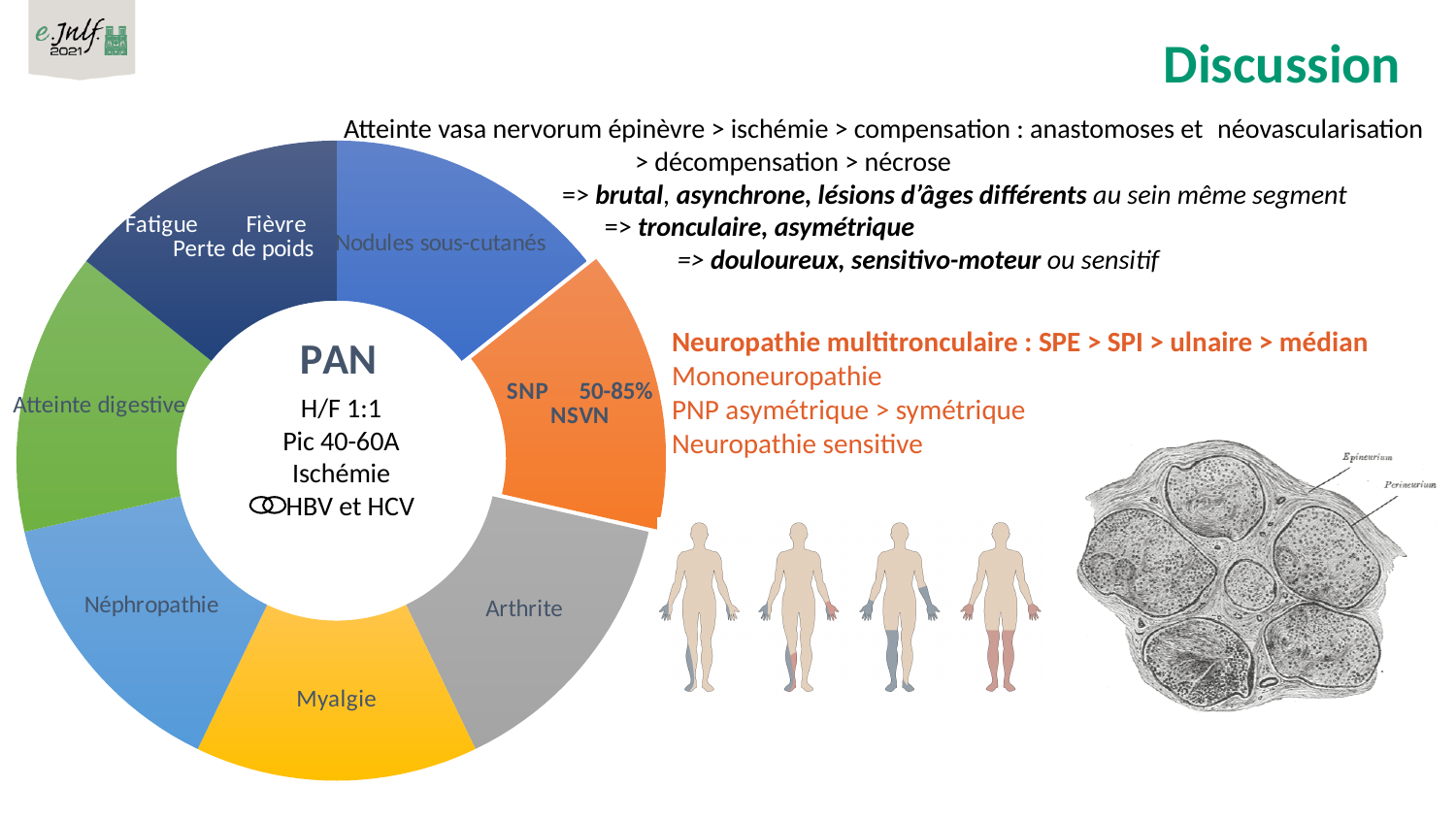
What percentage is printed on the SNP / NSVN segment of the doughnut chart? 50-85% Which segment of the doughnut chart is pulled out (exploded) from the ring? SNP 50-85% NSVN What kind of chart is shown on the left of the slide? Doughnut chart How many segments does the doughnut chart have? 7 What label appears in large bold text at the centre of the doughnut chart? PAN